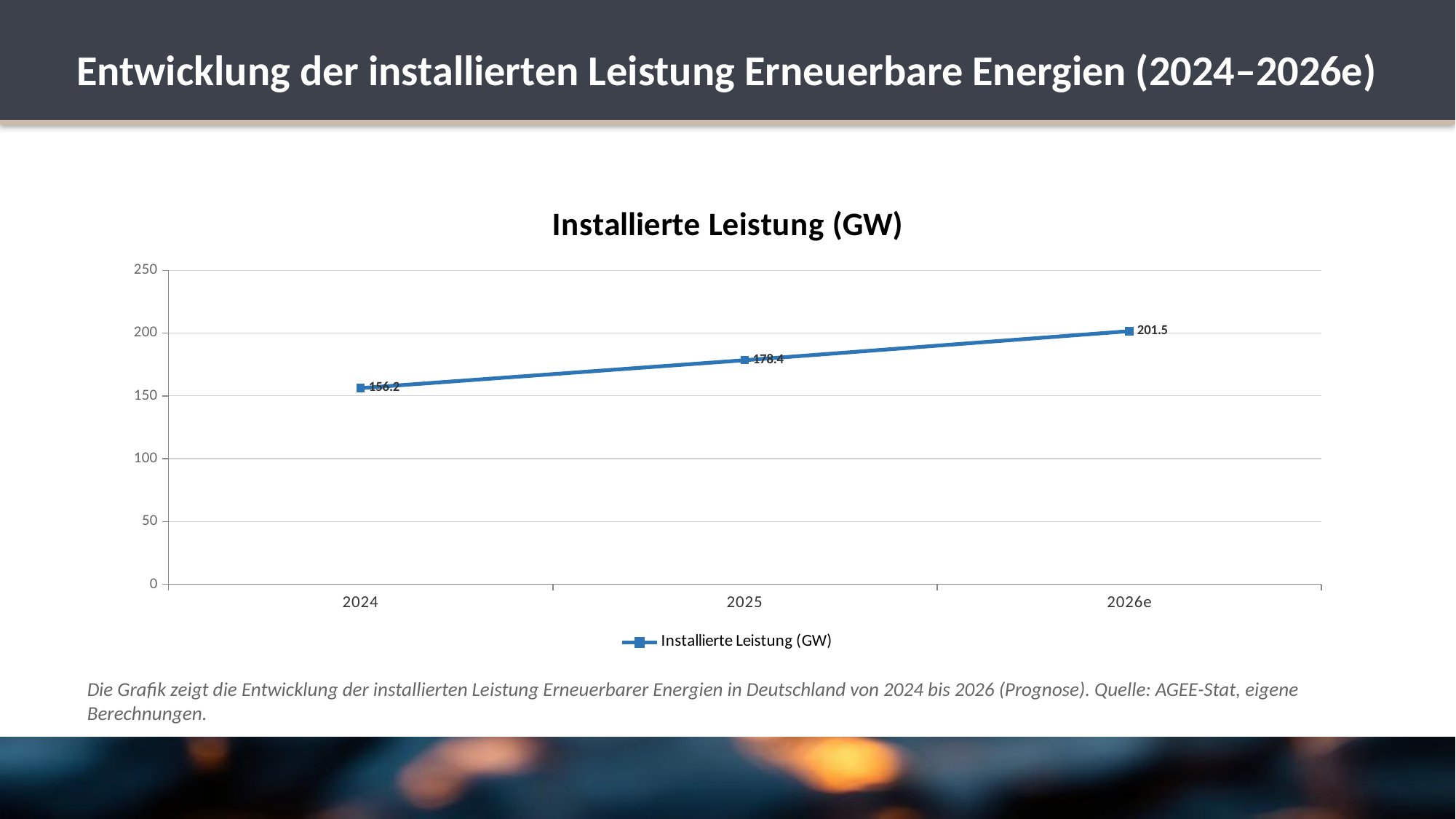
What is the difference between the 2026e and 2024 values? 45.3 What kind of chart is shown on the slide? line chart What is the difference between the 2025 and 2024 values? 22.2 Which is larger, the value for 2025 or the value for 2026e? 2026e How many data points are plotted on the chart? 3 Do the values rise or fall from 2024 to 2026e? rise What is the installed capacity value shown for 2025? 178.4 What is the installed capacity value shown for 2024? 156.2 Is the value for 2026e greater or less than 200? greater What is the installed capacity value shown for 2026e? 201.5 Which year has the highest installed capacity? 2026e Which year has the lowest installed capacity? 2024